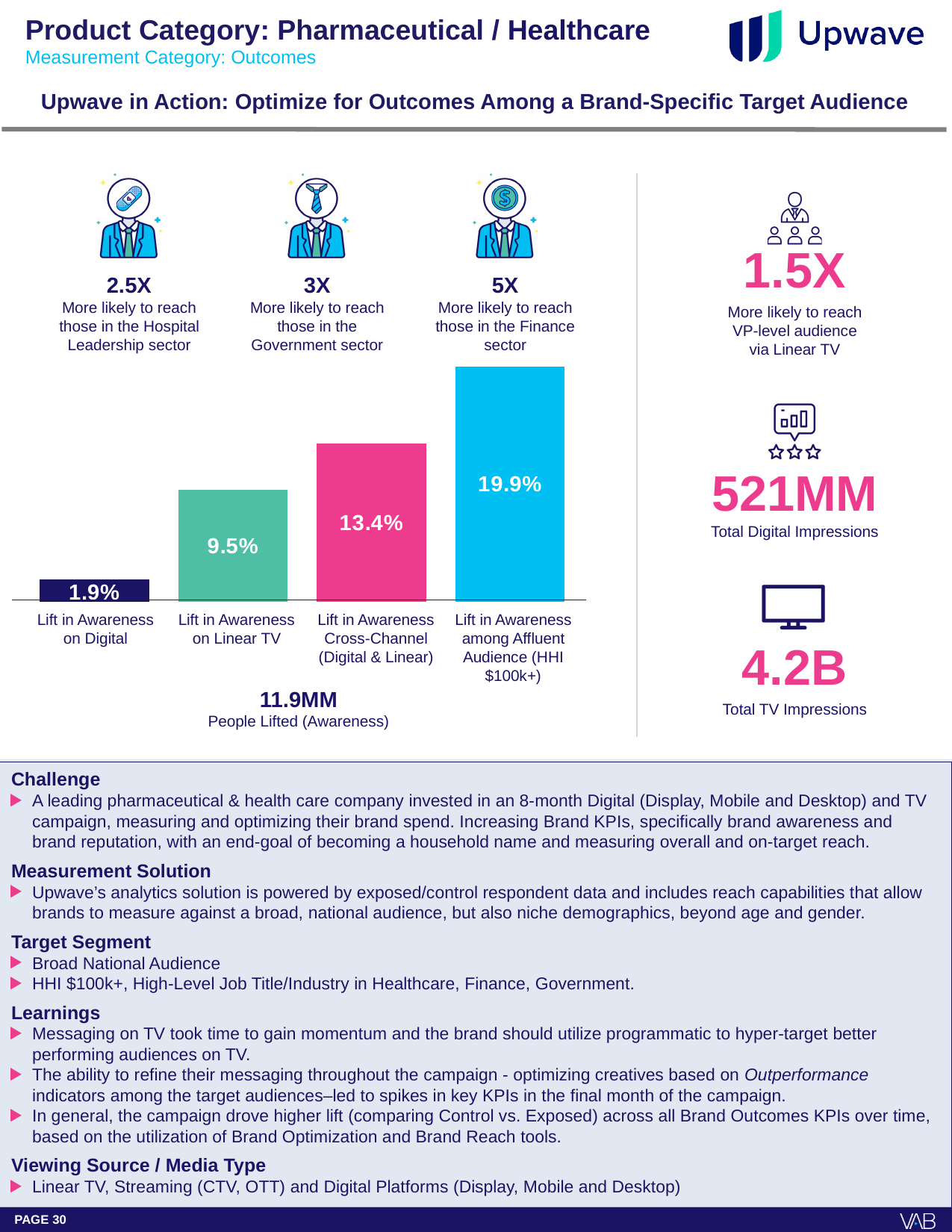
Which is larger: the lift in awareness Cross-Channel or on Linear TV? Cross-Channel Which category has the highest lift in awareness? Lift in Awareness among Affluent Audience (HHI $100k+) What is the value for Lift in Awareness among Affluent Audience (HHI $100k+)? 19.9% What kind of chart is shown on the slide? Bar chart What is the value for Lift in Awareness Cross-Channel (Digital & Linear)? 13.4% What is the value for Lift in Awareness on Linear TV? 9.5% Do the bar values rise or fall from left to right across the chart? Rise What is the difference between the lift in awareness among the Affluent Audience and Cross-Channel? 6.5% What is the value for Lift in Awareness on Digital? 1.9% Which category has the lowest lift in awareness? Lift in Awareness on Digital How many bars are shown in the chart? 4 What is the difference between the lift in awareness on Linear TV and on Digital? 7.6%